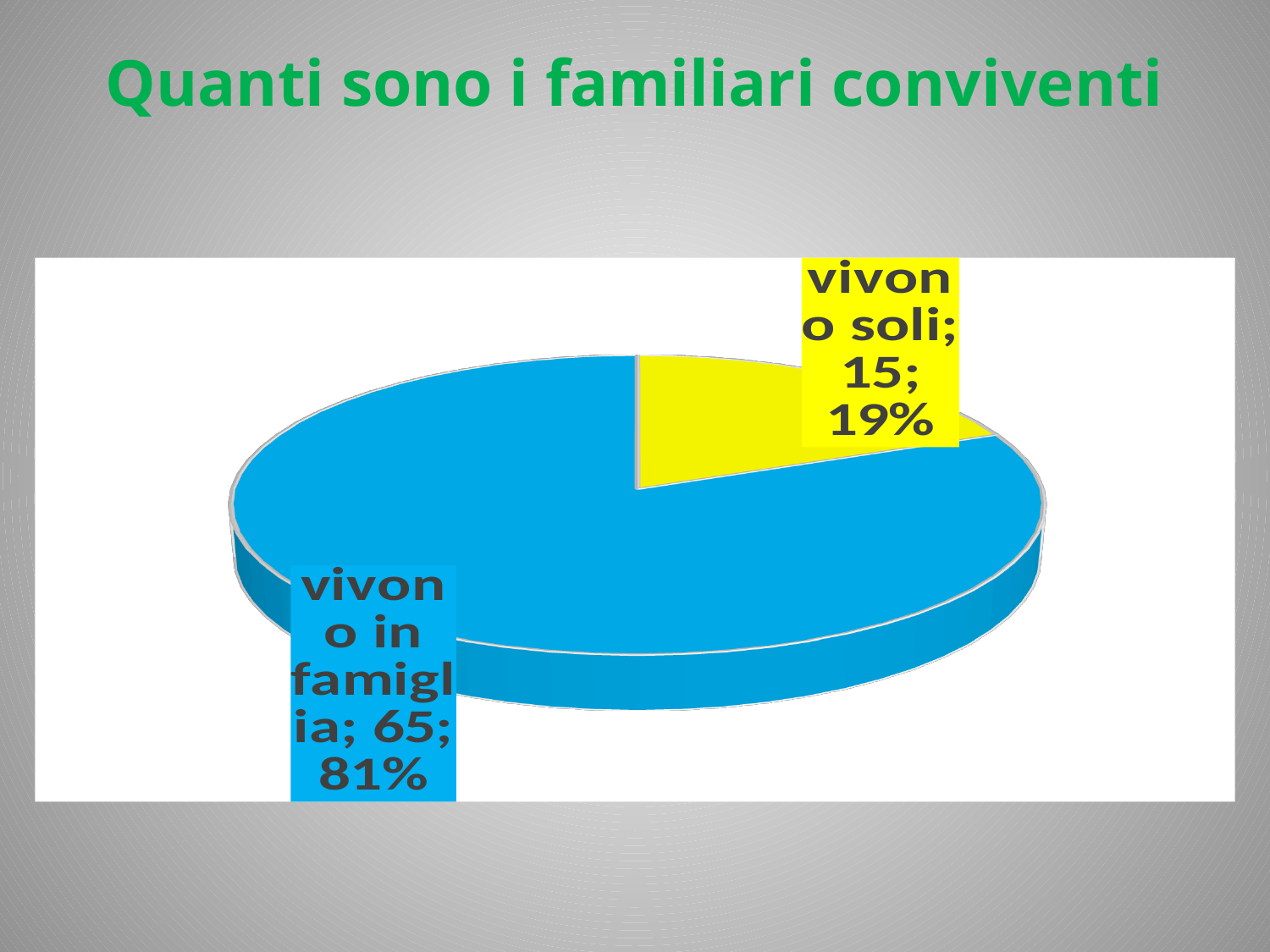
What share of the pie does "vivono soli" represent? 19% What is the value for "vivono in famiglia"? 65 What is the title of the slide? Quanti sono i familiari conviventi Which category has the largest slice? vivono in famiglia What kind of chart is shown on the slide? pie chart What is the total of the two values shown in the pie chart? 80 What share of the pie does "vivono in famiglia" represent? 81% What is the value for "vivono soli"? 15 Which is larger, the value for "vivono soli" or the value for "vivono in famiglia"? vivono in famiglia Which category has the smallest slice? vivono soli How many slices does the pie chart have? 2 What is the difference between the values for "vivono in famiglia" and "vivono soli"? 50